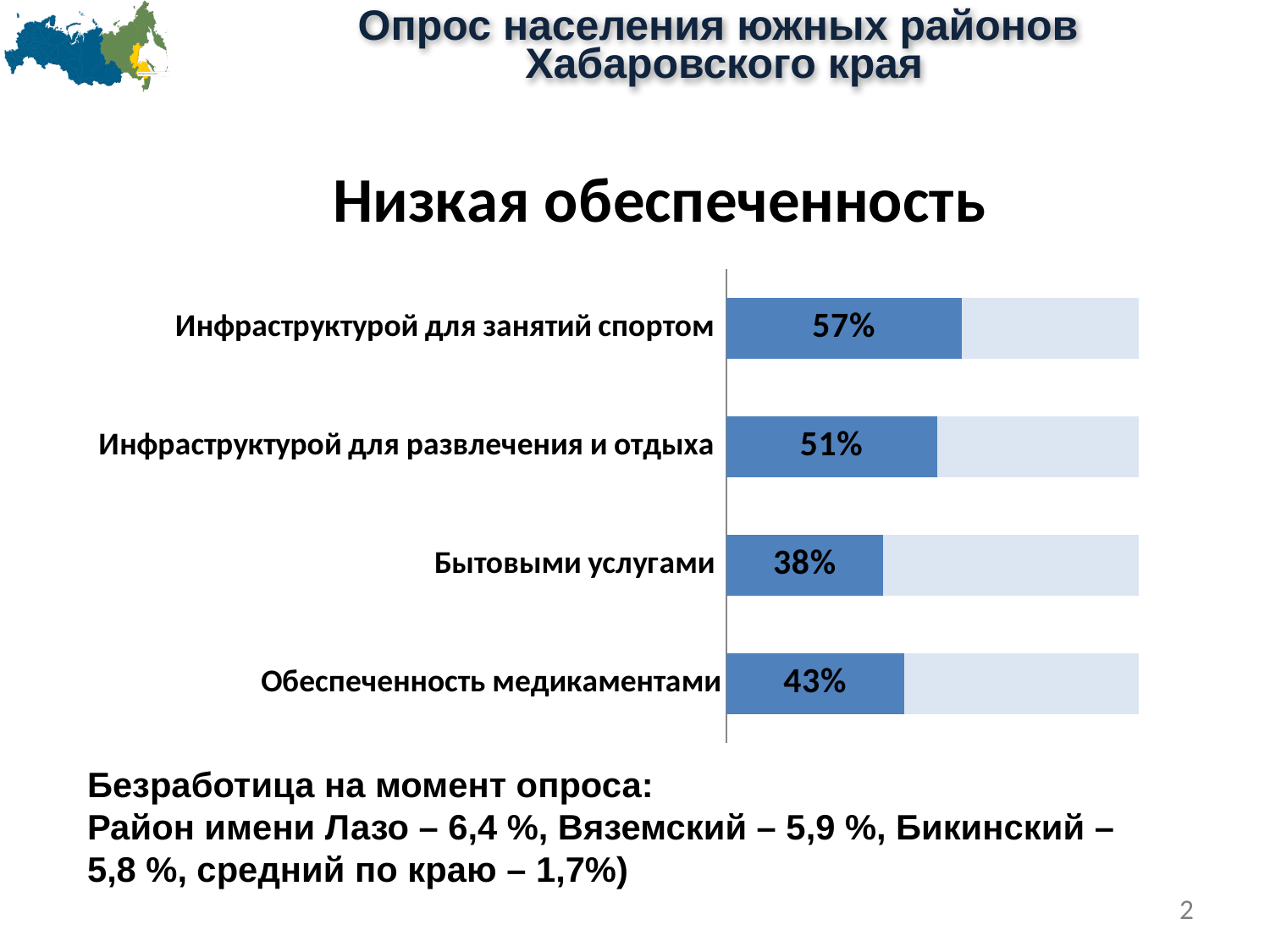
What is the value for "Инфраструктурой для занятий спортом"? 57% What is the value for "Инфраструктурой для развлечения и отдыха"? 51% What is the value for "Бытовыми услугами"? 38% Which is larger: the value for "Обеспеченность медикаментами" or for "Бытовыми услугами"? Обеспеченность медикаментами What kind of chart is shown on the slide? Bar chart What is the difference between the values for "Инфраструктурой для развлечения и отдыха" and "Обеспеченность медикаментами"? 8% What is the value for "Обеспеченность медикаментами"? 43% What is the title of the chart? Низкая обеспеченность How many categories are shown in the chart? 4 What is the difference between the values for "Инфраструктурой для занятий спортом" and "Бытовыми услугами"? 19% Which category has the highest value? Инфраструктурой для занятий спортом Which category has the lowest value? Бытовыми услугами